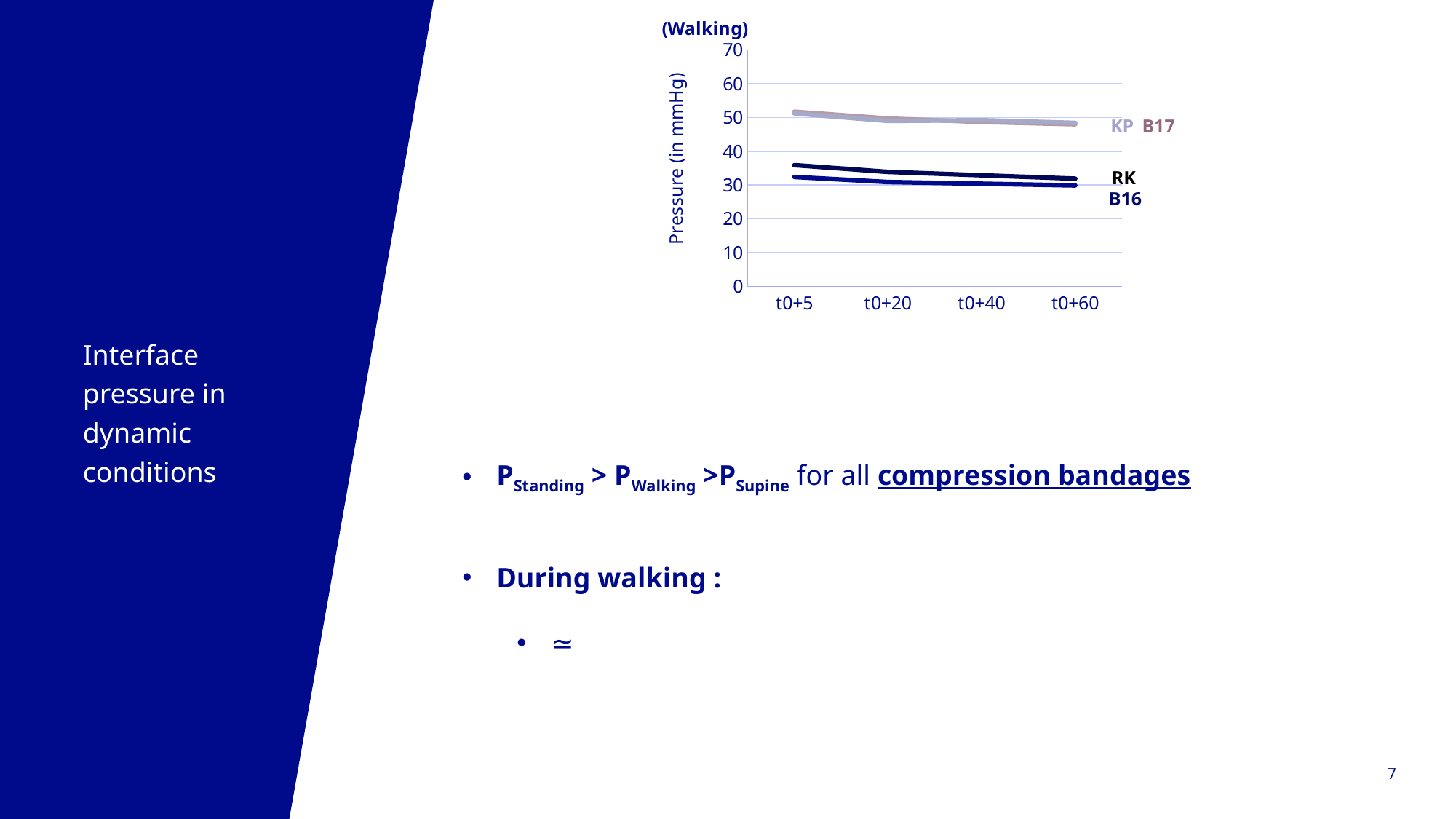
Do the values for RK rise or fall from t0+5 to t0+60? fall What is the title of the chart? (Walking) Which is larger at t0+5, the value for RK or the value for B16? RK Is the value for B17 at t0+60 greater or less than 60? less Is the value for KP at t0+5 greater or less than 40? greater What kind of chart is shown on the slide? line chart Is the value for RK at t0+5 greater or less than 30? greater Which is larger at t0+20, the value for KP or the value for RK? KP Do the values for KP rise or fall from t0+5 to t0+60? fall How many time points are shown on the x axis of the chart? 4 What is the label of the y axis of the chart? Pressure (in mmHg)